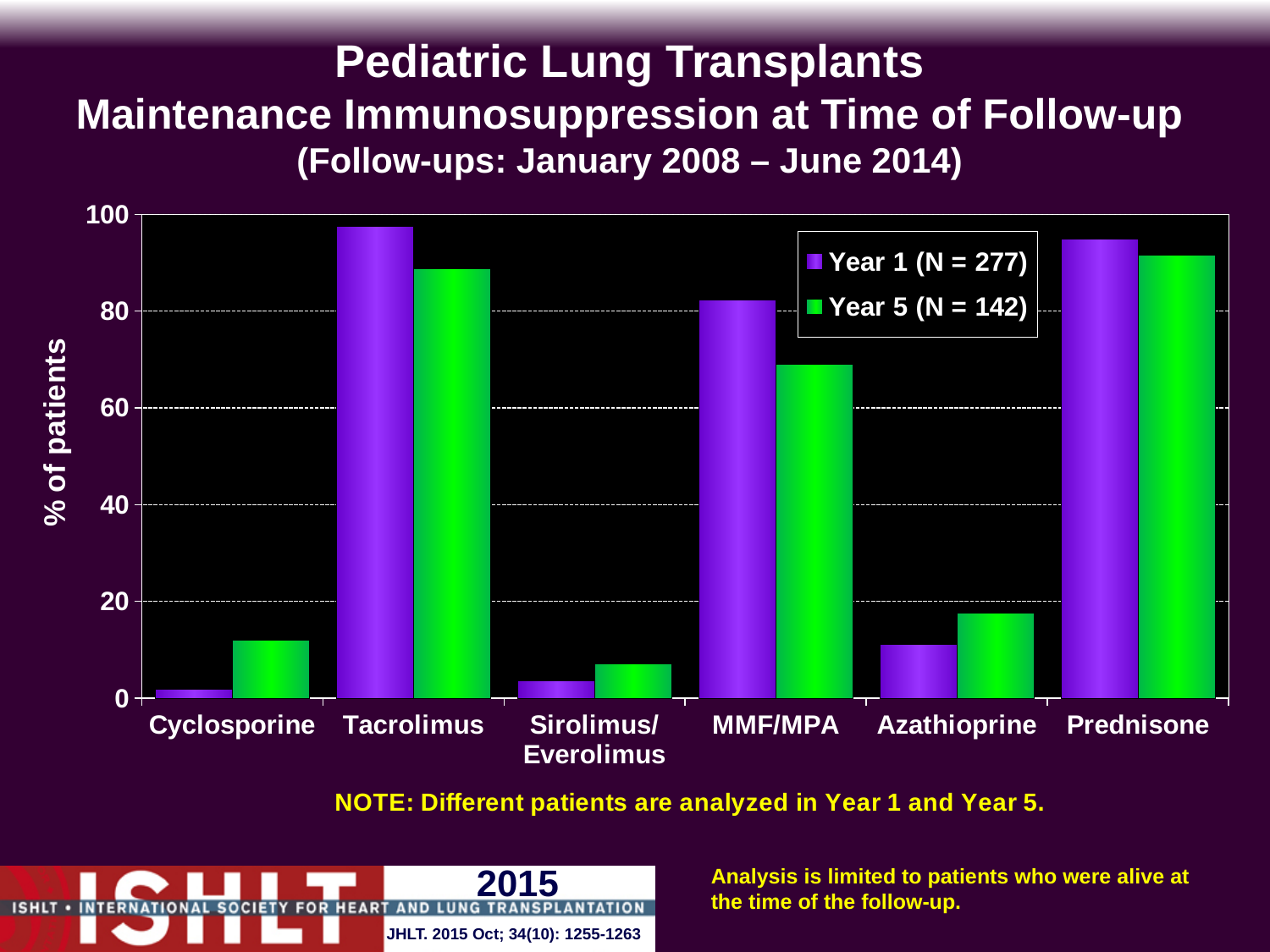
What is the label of the y axis? % of patients Is the Year 5 value for Azathioprine greater or less than 20? less How many drug categories are shown on the x axis? 6 How many series does the legend list? 2 Which drug has the lowest Year 5 value? Sirolimus/Everolimus Is the Year 5 value for Prednisone greater or less than 80? greater Is the Year 1 value for Cyclosporine greater or less than 20? less For MMF/MPA, which is larger: the Year 1 value or the Year 5 value? Year 1 For Cyclosporine, which is larger: the Year 1 value or the Year 5 value? Year 5 What kind of chart is shown on the slide? bar chart